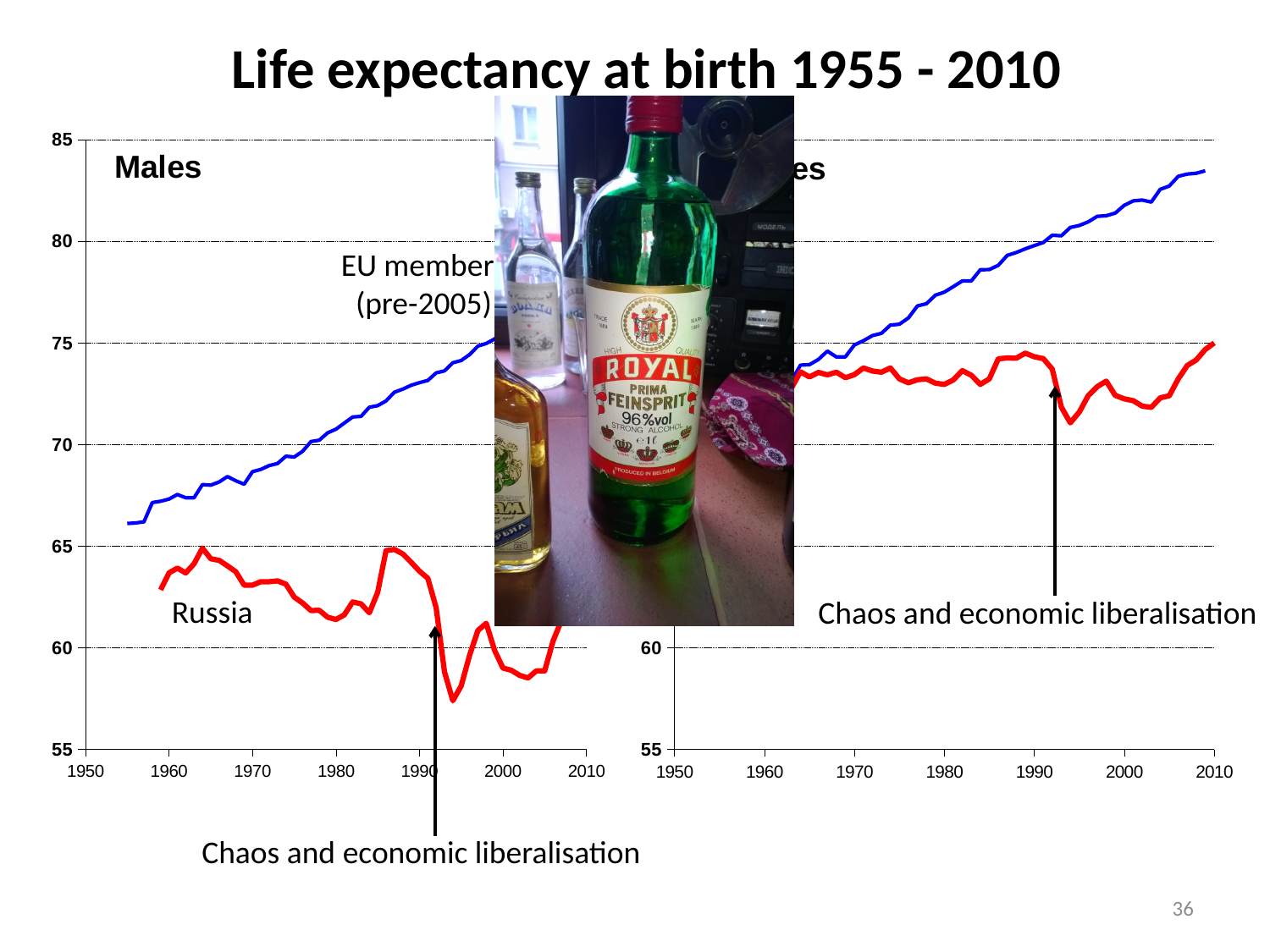
In the Males chart, does the EU member (pre-2005) line rise or fall from 1955 to 2010? rise What kind of chart is the left (Males) chart? line chart In the right-hand chart, is the red line's value around 1994 greater or less than 75? less In the Males chart, which line is higher in 1990, EU member (pre-2005) or Russia? EU member (pre-2005) In the Males chart, what colour is the Russia line? red In the Males chart, is the Russia value around 1994 greater or less than 60? less How many lines are plotted in the Males chart? 2 In the right-hand chart, does the blue line rise or fall over the period shown? rise In the Males chart, is the Russia value in 1964 greater or less than 60? greater What is the title of the slide's charts? Life expectancy at birth 1955 - 2010